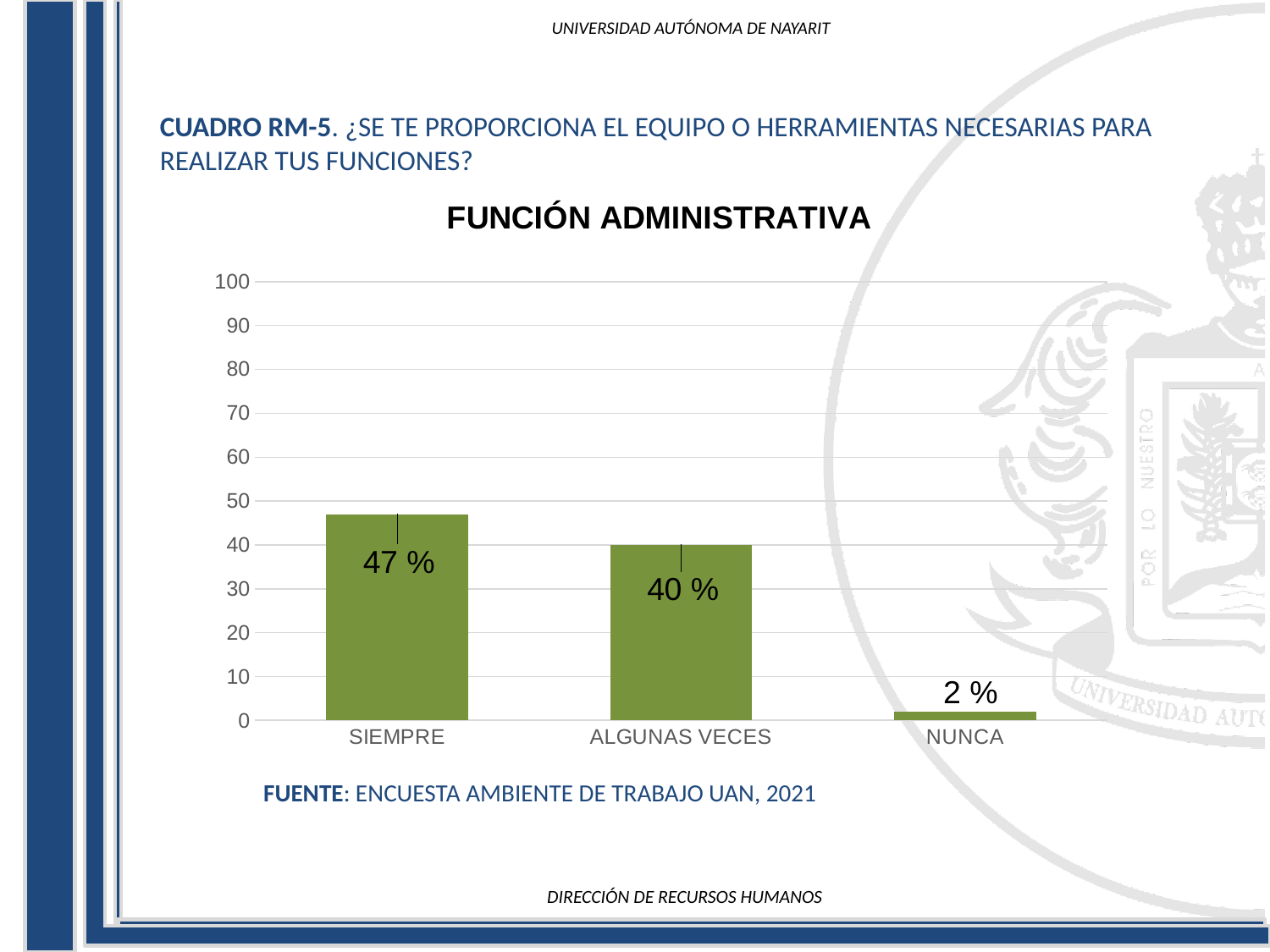
What is the value for SIEMPRE? 47 % Which is larger, the value for SIEMPRE or the value for NUNCA? SIEMPRE How many categories are shown on the x axis? 3 Which category has the highest value? SIEMPRE What is the difference between the values for ALGUNAS VECES and NUNCA? 38 % What is the title of the chart? FUNCIÓN ADMINISTRATIVA What is the difference between the values for SIEMPRE and ALGUNAS VECES? 7 % What is the value for ALGUNAS VECES? 40 % What is the value for NUNCA? 2 % What kind of chart is shown? bar chart Is the value for SIEMPRE greater or less than 50? less Which category has the lowest value? NUNCA